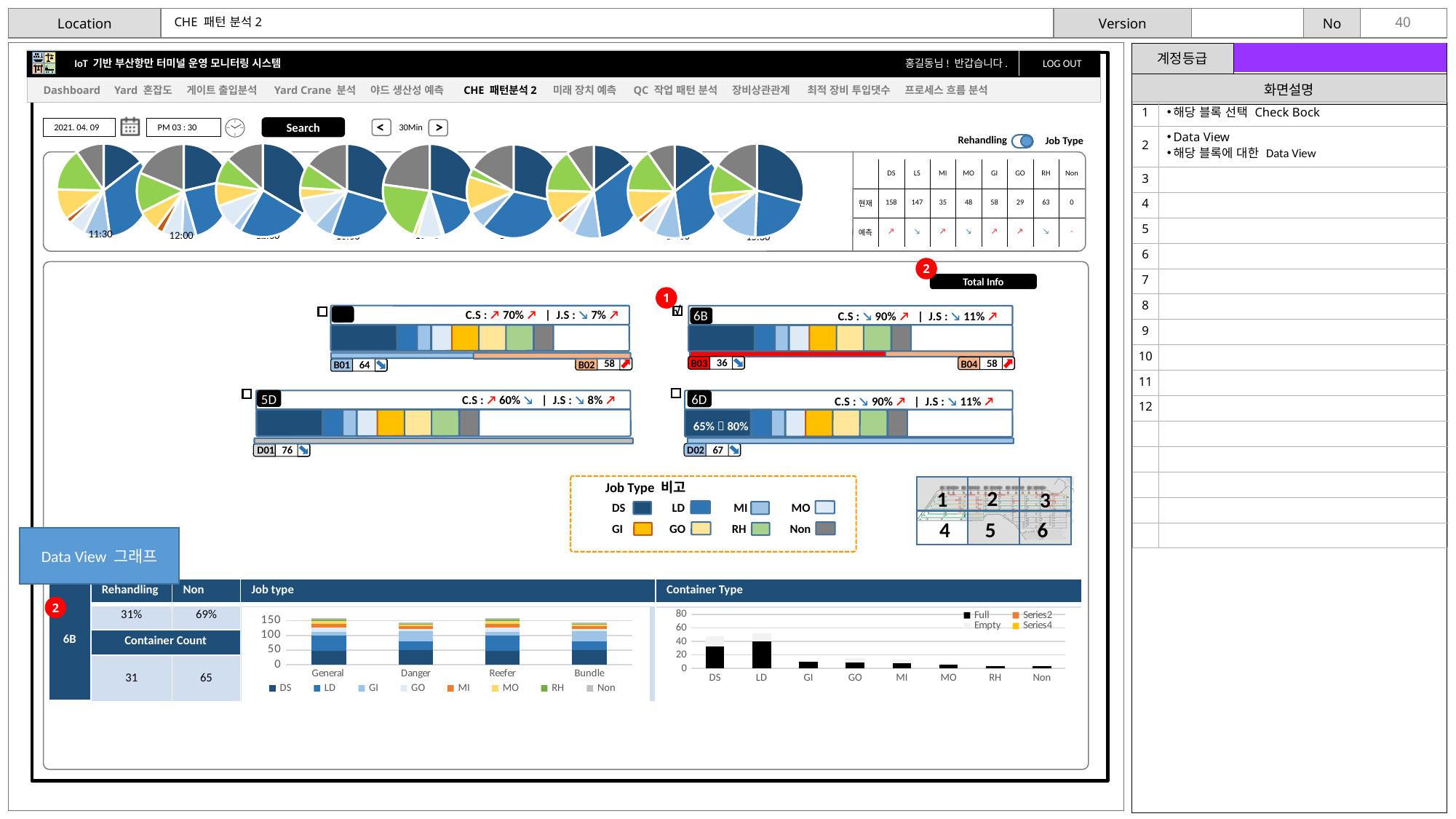
In the "Container Type" chart, which category has the tallest bar? LD How many categories are shown on the x axis of the "Container Type" chart? 8 What kind of chart is the "Container Type" chart? bar chart In the "Container Type" chart, is the value for GI greater or less than 20? less In the "Container Type" chart, is the value for DS greater or less than 20? greater How many series does the legend of the "Job type" chart list? 8 In the "Container Type" chart, which is larger, the bar for DS or the bar for GO? DS What kind of chart is the "Job type" chart? bar chart What is the first category listed on the x axis of the "Job type" chart? General How many series does the legend of the "Container Type" chart list? 4 How many categories are shown on the x axis of the "Job type" chart? 4 In the "Job type" chart, is the total stacked value for General greater or less than 100? greater